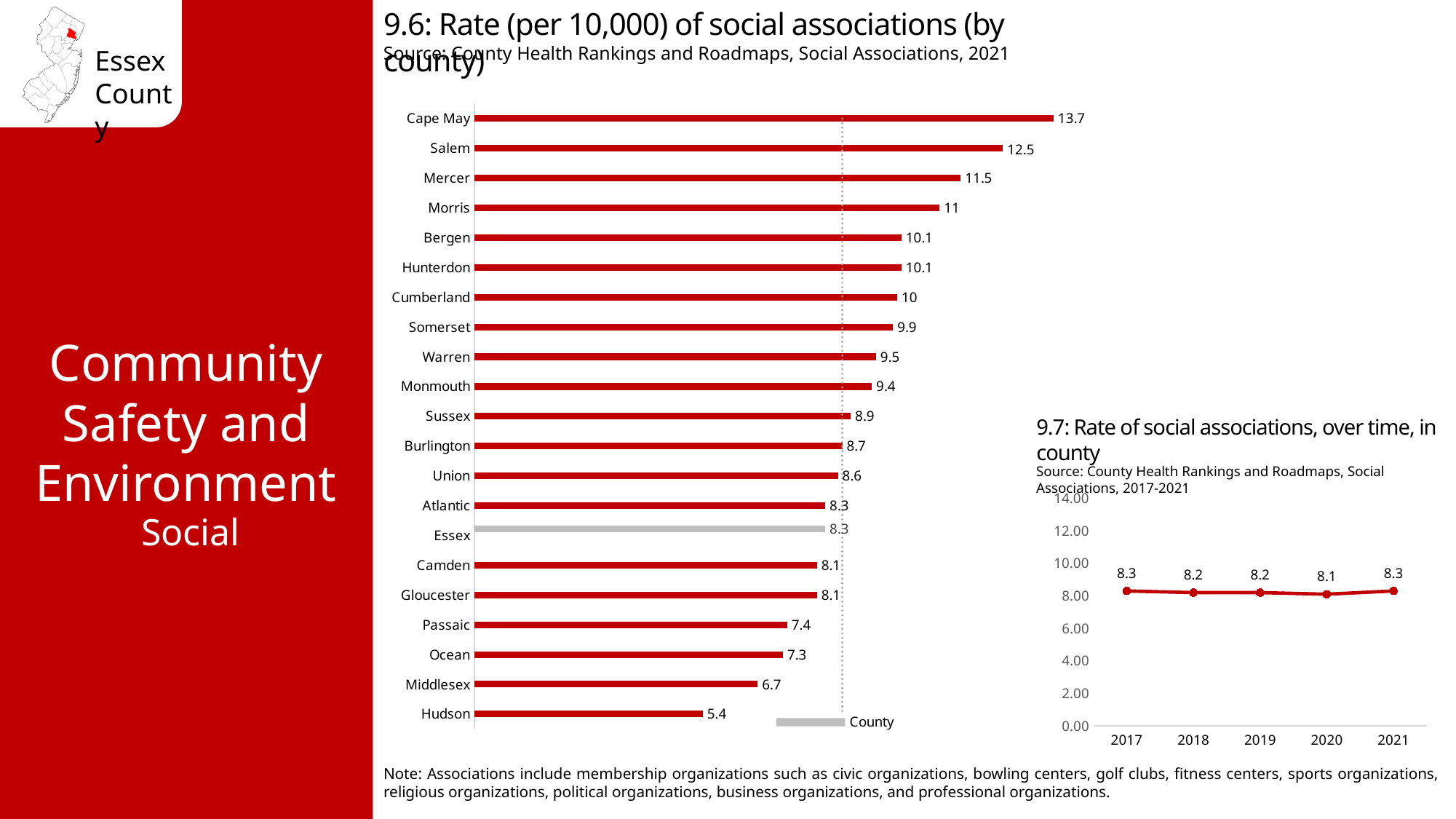
In chart 9.7 (rate of social associations over time), is the value for 2019 greater or less than 10.00? less In chart 9.7 (rate of social associations over time), how many years are plotted? 5 In chart 9.6 (rate of social associations by county), what is the value for Essex? 8.3 In chart 9.7 (rate of social associations over time), what is the value for 2020? 8.1 In chart 9.6 (rate of social associations by county), how many counties are shown? 21 In chart 9.6 (rate of social associations by county), which bar is shown in grey rather than red? Essex In chart 9.6 (rate of social associations by county), what is the difference between Cape May and Salem? 1.2 In chart 9.6 (rate of social associations by county), which county has the highest rate? Cape May In chart 9.6 (rate of social associations by county), which has a higher rate, Mercer or Morris? Mercer In chart 9.6 (rate of social associations by county), what is the value for Hudson? 5.4 In chart 9.6 (rate of social associations by county), which county has the lowest rate? Hudson What kind of chart is chart 9.6 (rate of social associations by county)? Bar chart